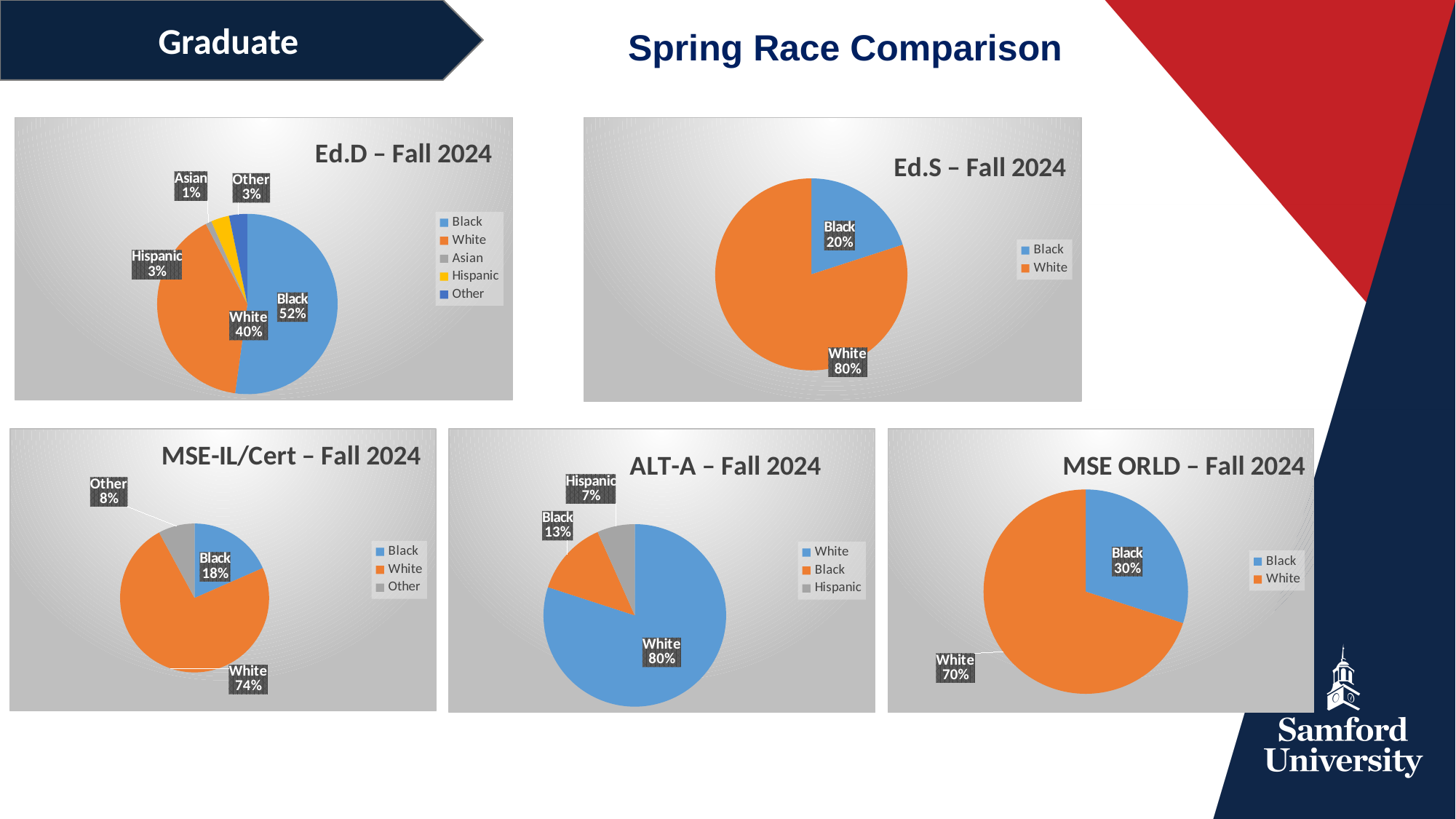
In the MSE ORLD – Fall 2024 chart, what is the value for Black? 30% In the Ed.S – Fall 2024 chart, what is the value for White? 80% In the Ed.D – Fall 2024 chart, which category has the smallest slice? Asian In the MSE-IL/Cert – Fall 2024 chart, what is the value for Other? 8% In the Ed.D – Fall 2024 chart, what is the value for Hispanic? 3% How many categories does the legend list in the Ed.D – Fall 2024 chart? 5 In the Ed.D – Fall 2024 chart, what share of the pie is Black? 52% In the ALT-A – Fall 2024 chart, what is the value for Black? 13% What type of chart is the MSE ORLD – Fall 2024 chart? Pie chart In the Ed.S – Fall 2024 chart, what is the difference between the White and Black shares? 60% In the ALT-A – Fall 2024 chart, which is larger, Black or Hispanic? Black In the MSE-IL/Cert – Fall 2024 chart, which category has the largest slice? White